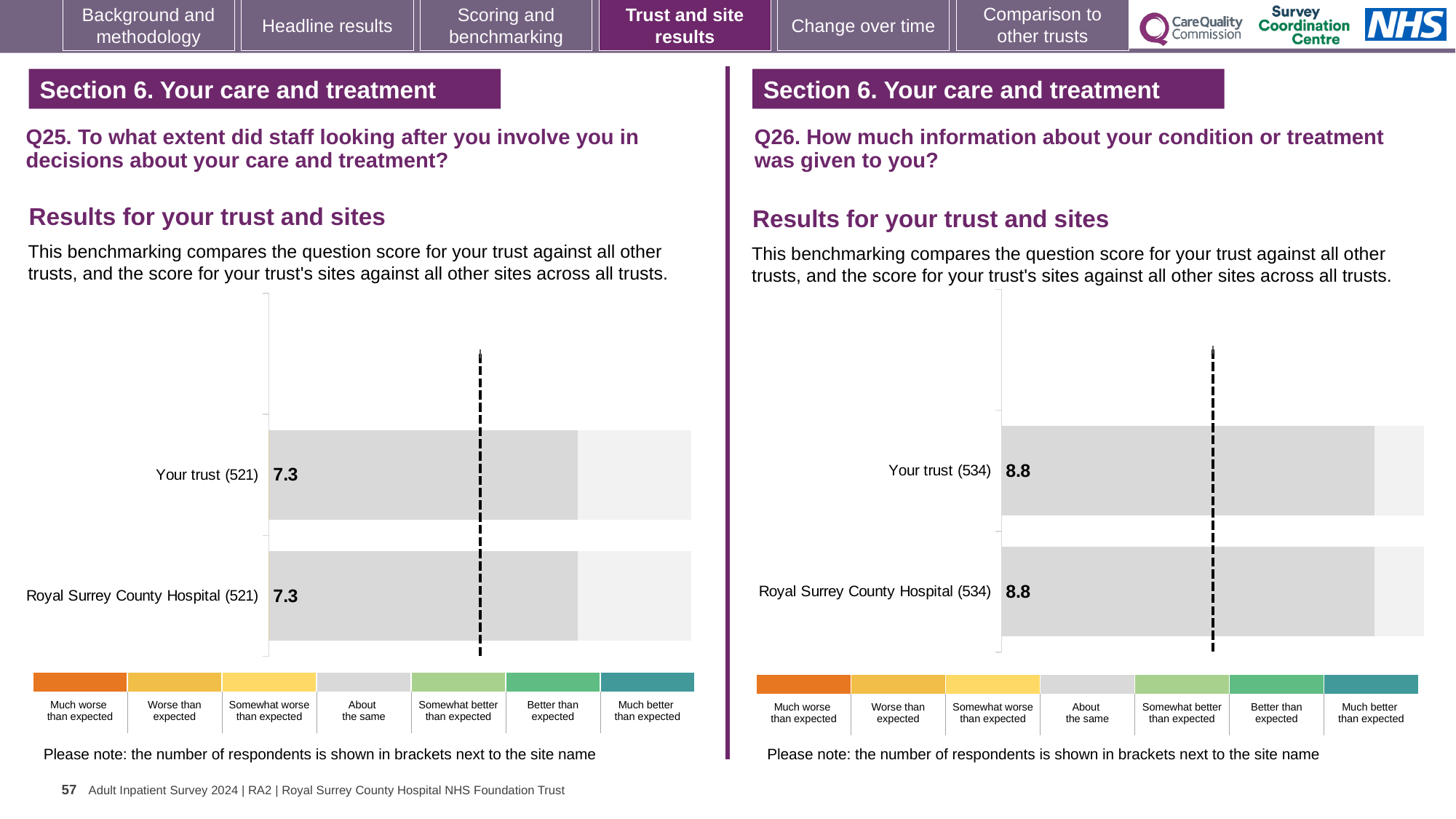
In the Q25 chart on the left, what is the difference between the Your trust score and the Royal Surrey County Hospital score? 0 What kind of chart is the Q25 chart on the left? Bar chart In the Q25 chart on the left, what is the score for Royal Surrey County Hospital? 7.3 In the Q25 chart on the left, how many respondents are shown in brackets for Royal Surrey County Hospital? 521 In the Q26 chart on the right, what is the score for Royal Surrey County Hospital? 8.8 In the Q25 chart on the left, what is the score for Your trust? 7.3 In the Q26 chart on the right, how many respondents are shown in brackets for Your trust? 534 In the Q26 chart on the right, how many bars are plotted? 2 In the Q26 chart on the right, what is the score for Your trust? 8.8 In the Q25 chart on the left, how many bars are plotted? 2 Which chart has the higher score for Your trust, the Q25 chart on the left or the Q26 chart on the right? Q26 chart on the right In the Q26 chart on the right, how many categories does the colour key below the chart list? 7